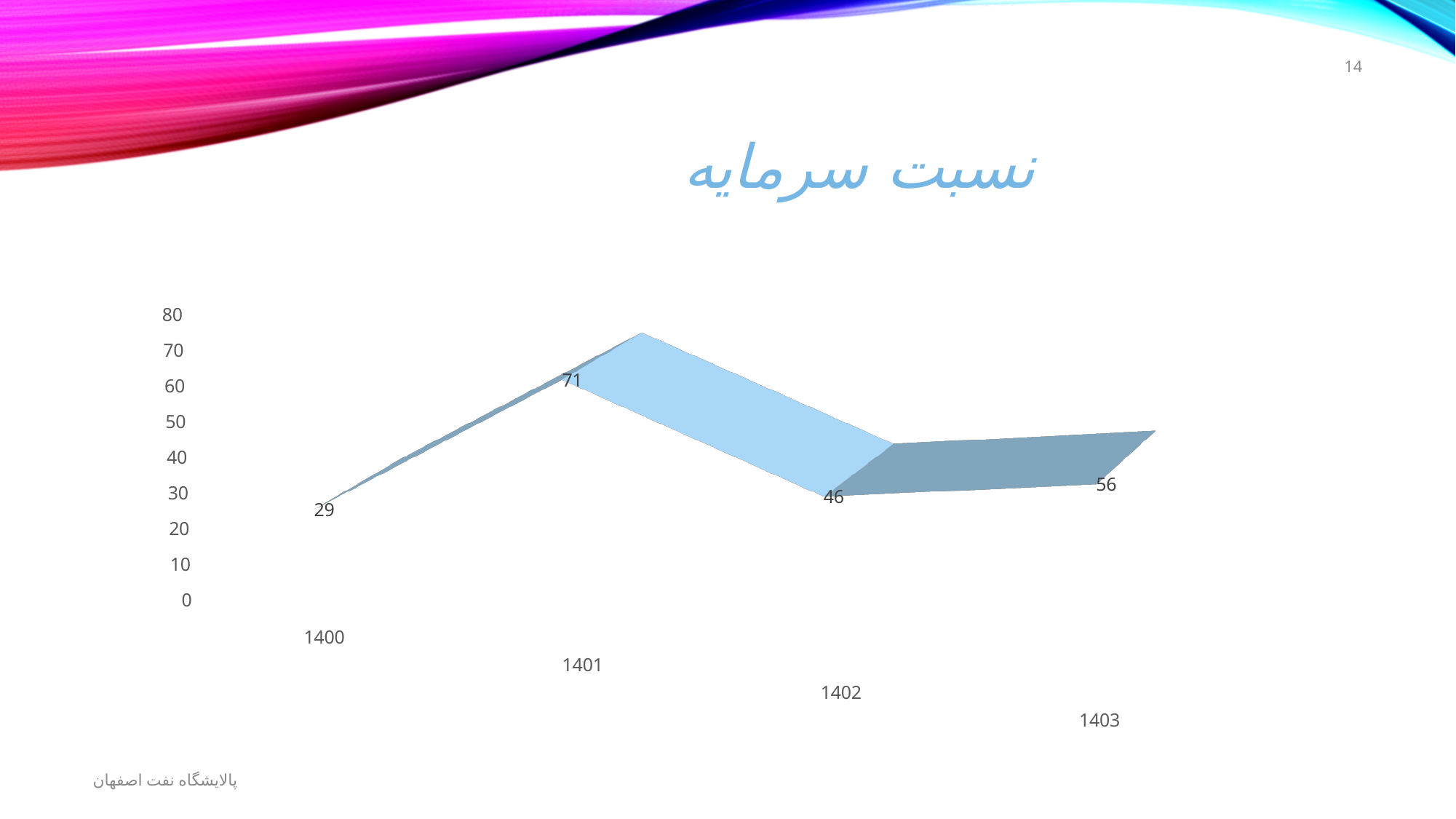
What is the value for 1401? 71 What kind of chart is shown on the slide? line chart What is the value for 1402? 46 Does the value rise or fall from 1401 to 1402? fall Which year has the highest value? 1401 What is the difference between the values for 1401 and 1400? 42 What is the value for 1403? 56 Which is larger, the value for 1402 or the value for 1403? 1403 What is the difference between the values for 1403 and 1402? 10 Which year has the lowest value? 1400 How many years are plotted on the chart? 4 What is the value for 1400? 29